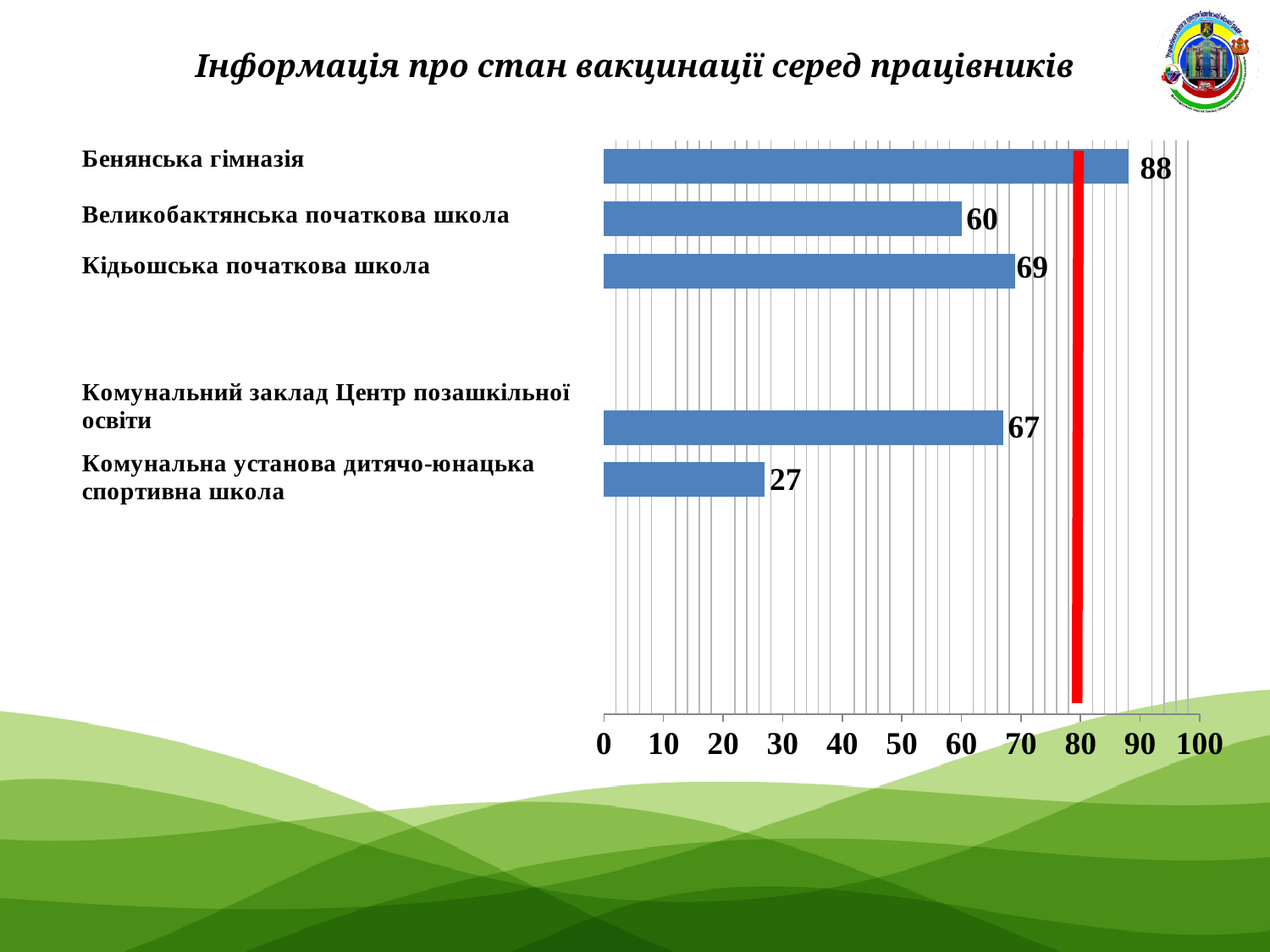
Which category has the lowest value? Комунальна установа дитячо-юнацька спортивна школа How many categories are shown in the chart? 5 What is the value for Бенянська гімназія? 88 What kind of chart is shown on the slide? bar chart What is the title of the slide? Інформація про стан вакцинації серед працівників Is the value for Комунальний заклад Центр позашкільної освіти greater or less than 80? less At what value on the axis is the red vertical line drawn? 80 Which category has the highest value? Бенянська гімназія What is the value for Великобактянська початкова школа? 60 Which is larger: the value for Кідьошська початкова школа or the value for Комунальний заклад Центр позашкільної освіти? Кідьошська початкова школа What is the difference between the values for Бенянська гімназія and Кідьошська початкова школа? 19 What is the value for Комунальна установа дитячо-юнацька спортивна школа? 27